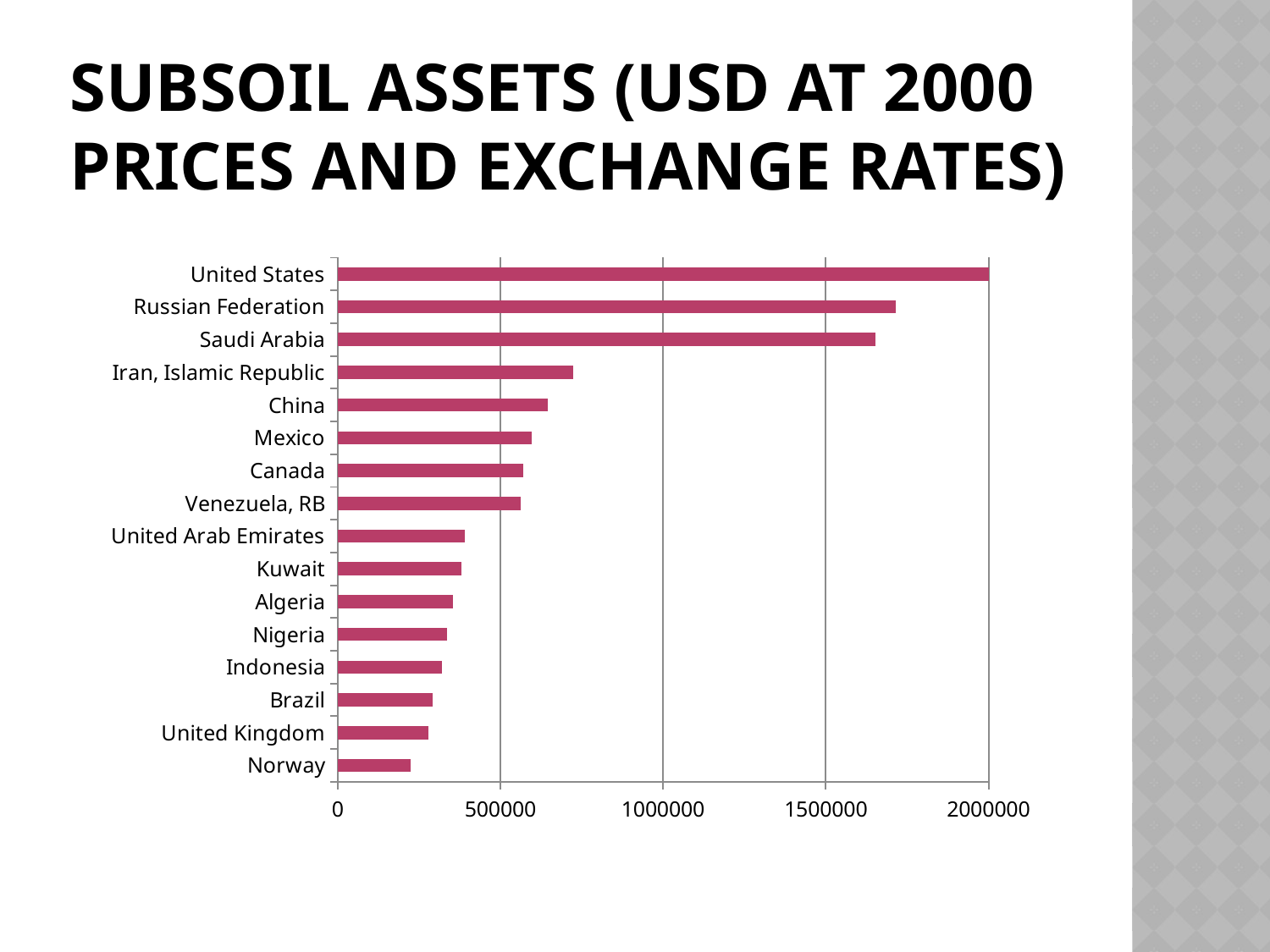
How many countries are shown in the chart? 16 Which has a larger value, Russian Federation or Iran, Islamic Republic? Russian Federation What kind of chart is shown on the slide? bar chart What is the highest value shown on the horizontal axis of the chart? 2000000 Is the value for Iran, Islamic Republic greater or less than 1000000? less Is the value for China greater or less than 500000? greater What is the title of the slide containing the chart? Subsoil assets (USD at 2000 prices and exchange rates) Is the value for Saudi Arabia greater or less than 1500000? greater Which has a larger value, Norway or Mexico? Mexico Which country has the lowest subsoil assets value in the chart? Norway Which country has the highest subsoil assets value in the chart? United States